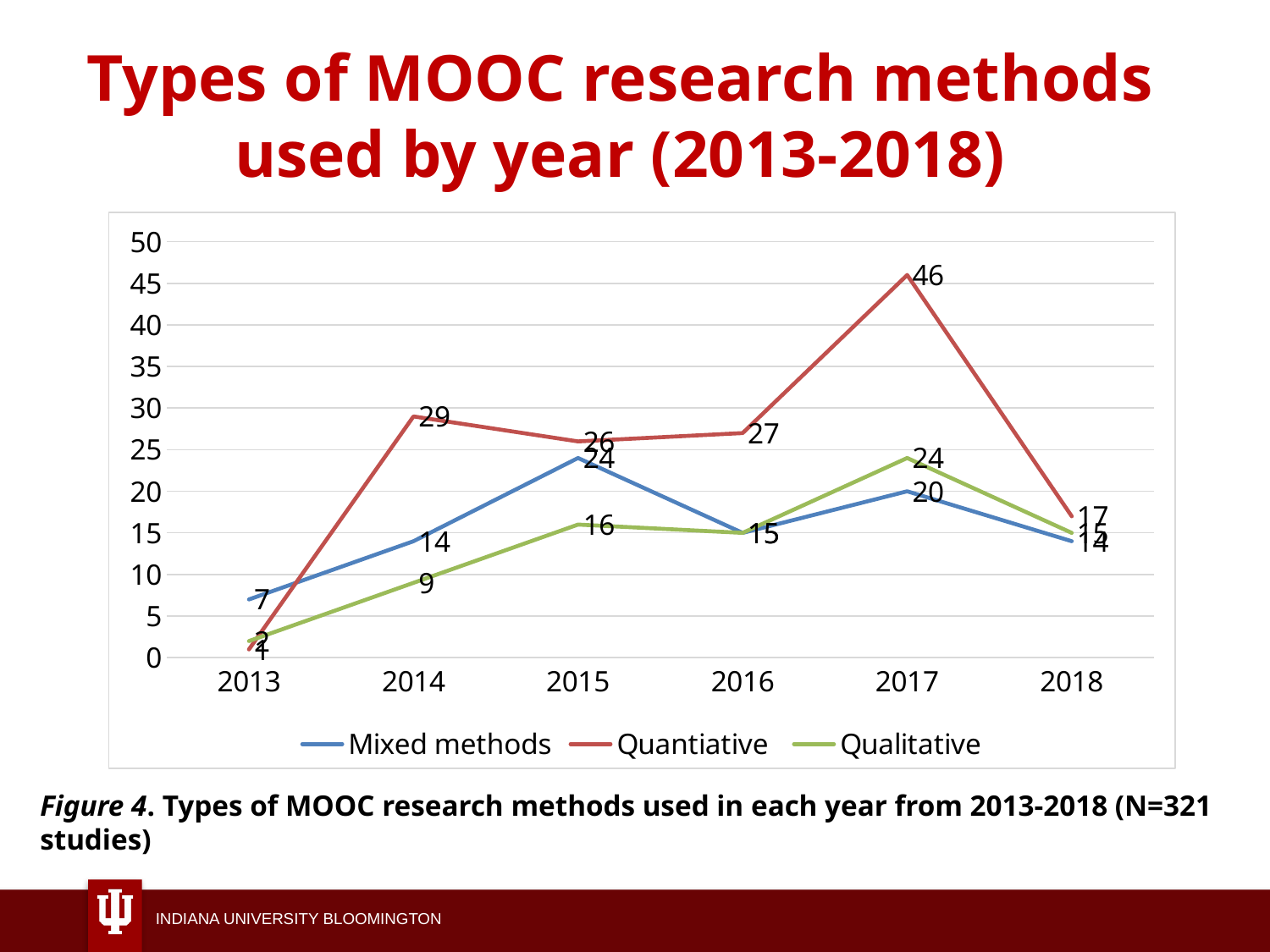
What is the value for Mixed methods in 2014? 14 In which year is the Mixed methods series at its lowest value? 2013 Is the value for Quantiative in 2017 greater or less than 40? greater What is the difference between the Quantiative values in 2017 and 2014? 17 In 2017, which is larger: Qualitative or Mixed methods? Qualitative In which year does the Quantiative series reach its highest value? 2017 What kind of chart is shown on the slide? line chart How many years are shown on the x axis? 6 What is the value for Qualitative in 2014? 9 What is the value for Quantiative in 2017? 46 What is the value for Qualitative in 2017? 24 How many series does the legend list? 3